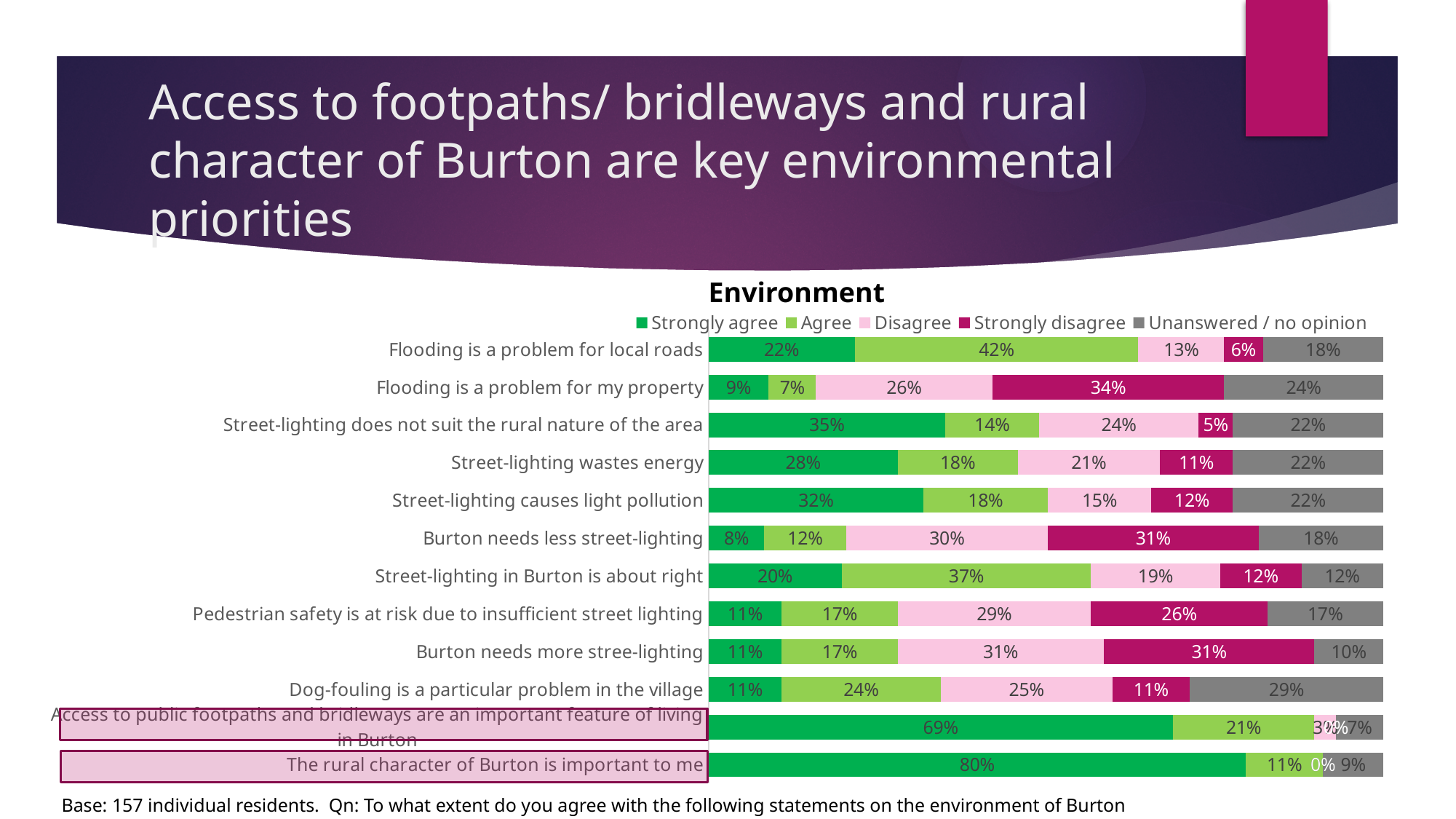
What percentage agree that flooding is a problem for local roads? 42% What is the Unanswered / no opinion percentage for 'Dog-fouling is a particular problem in the village'? 29% Which statement has the highest Strongly agree percentage? The rural character of Burton is important to me What is the title of the chart? Environment How many statements are shown in the chart? 12 What is the difference between the Strongly agree percentages for 'Street-lighting does not suit the rural nature of the area' and 'Street-lighting wastes energy'? 7% What percentage strongly disagree that flooding is a problem for their property? 34% Which is larger: the Strongly disagree percentage for 'Burton needs less street-lighting' or for 'Pedestrian safety is at risk due to insufficient street lighting'? Burton needs less street-lighting What percentage strongly agree that the rural character of Burton is important to them? 80% Which statement has the lowest Strongly agree percentage? Burton needs less street-lighting What type of chart is shown on the slide? Stacked bar chart How many series does the legend list? 5